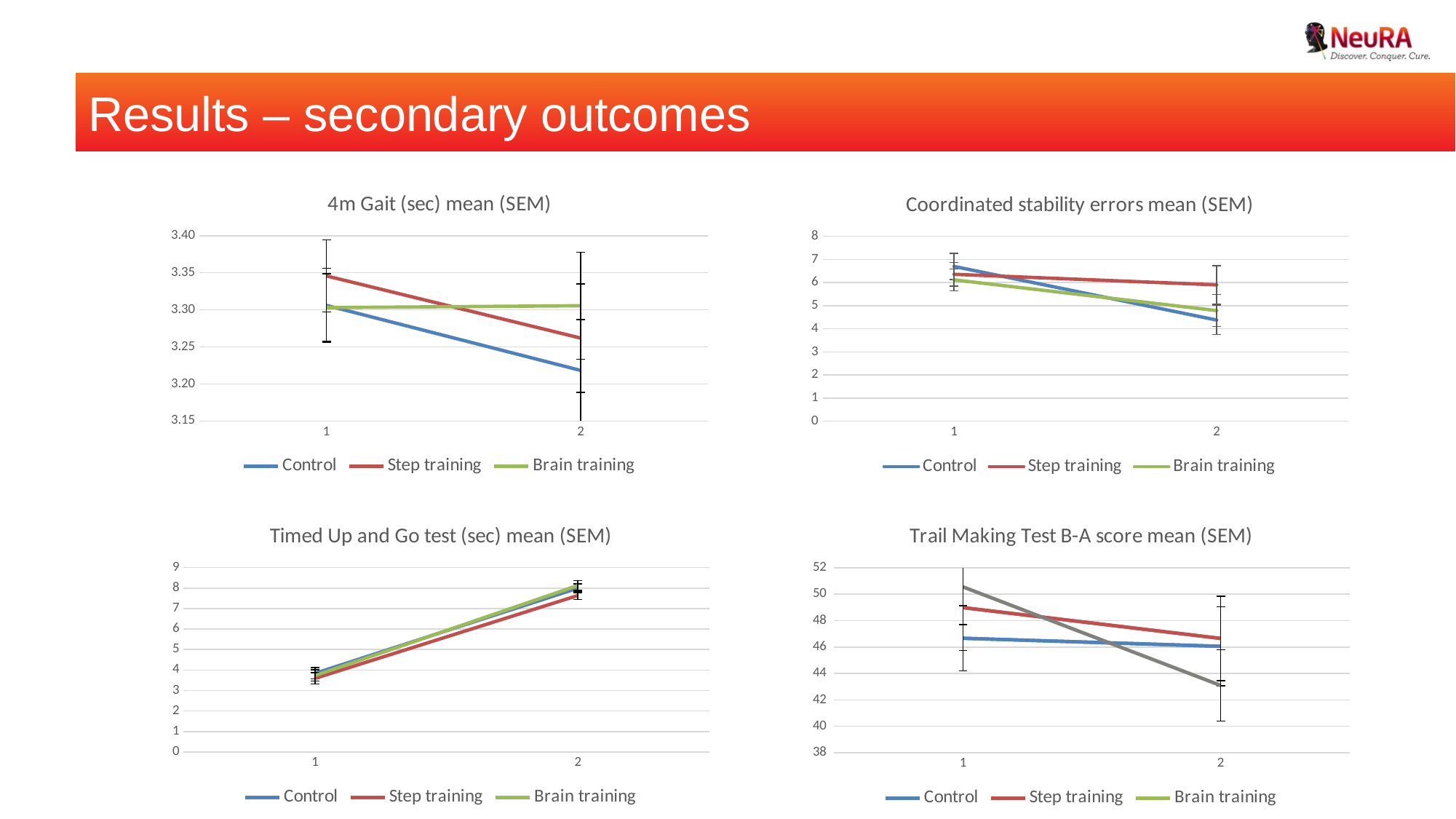
In the 'Timed Up and Go test (sec) mean (SEM)' chart, do the values rise or fall from time point 1 to time point 2? rise In the 'Trail Making Test B-A score mean (SEM)' chart, is the Step training value at time point 1 greater or less than 48? greater What kind of chart is the '4m Gait (sec) mean (SEM)' chart? line chart In the '4m Gait (sec) mean (SEM)' chart, is the Step training value at time point 1 greater or less than 3.30? greater How many points are plotted along the x axis for each series in the 'Timed Up and Go test (sec) mean (SEM)' chart? 2 In the 'Coordinated stability errors mean (SEM)' chart, does the Control series rise or fall from time point 1 to time point 2? fall How many series does the legend of the 'Coordinated stability errors mean (SEM)' chart list? 3 What is the title of the chart in the bottom-right of the slide? Trail Making Test B-A score mean (SEM) In the '4m Gait (sec) mean (SEM)' chart, is the Control value at time point 2 greater or less than 3.25? less In the 'Coordinated stability errors mean (SEM)' chart, which is larger at time point 2, Step training or Control? Step training